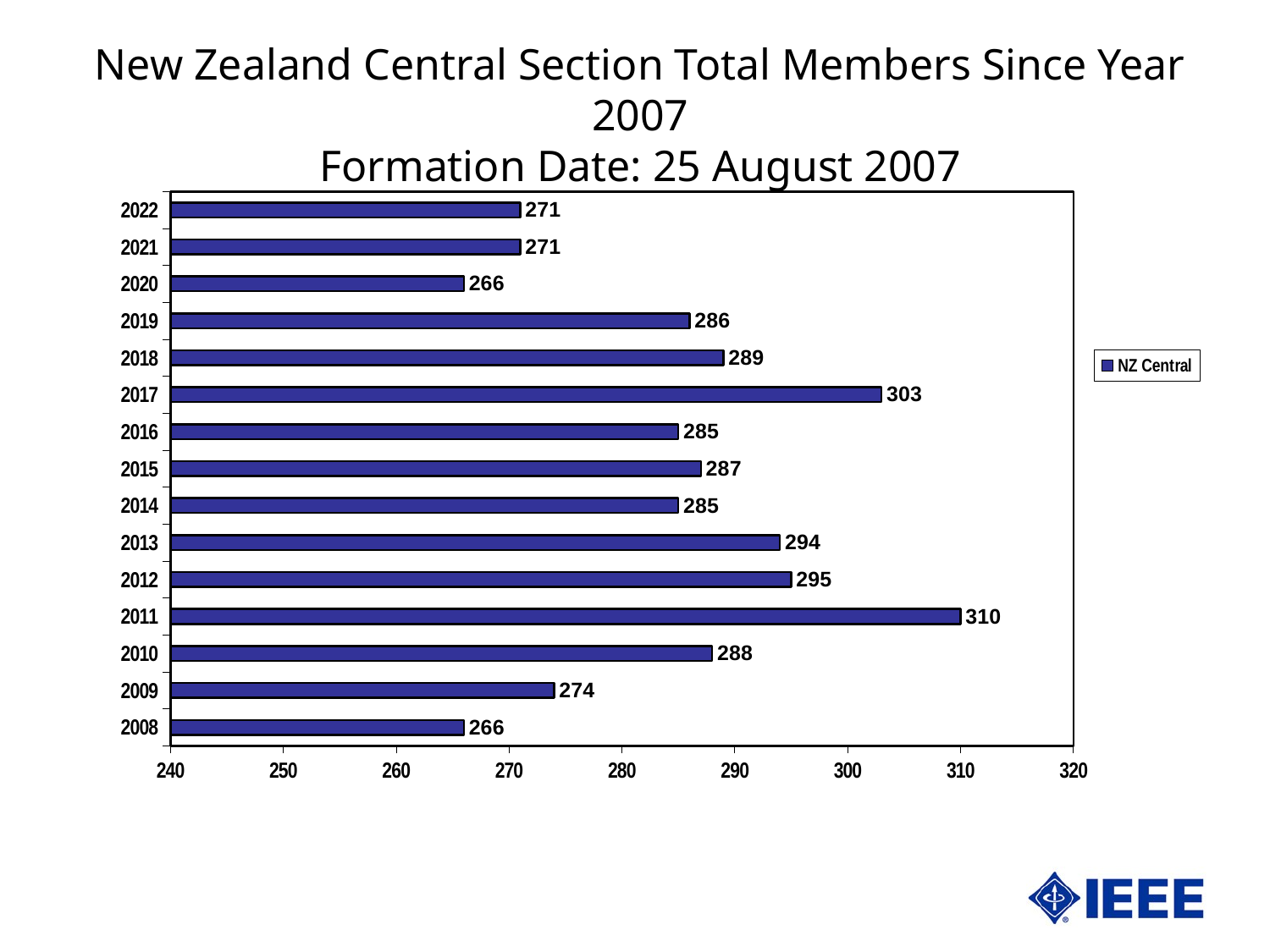
How many years are shown on the chart? 15 What is the value for 2020? 266 What is the value for 2017? 303 Which year has the highest value? 2011 How many series does the legend list? 1 What is the difference between the values for 2011 and 2012? 15 What is the difference between the values for 2019 and 2020? 20 What is the value for 2011? 310 What series name is shown in the legend? NZ Central What kind of chart is shown? bar chart Is the value for 2018 greater or less than 280? greater Which is larger, the value for 2013 or the value for 2014? 2013